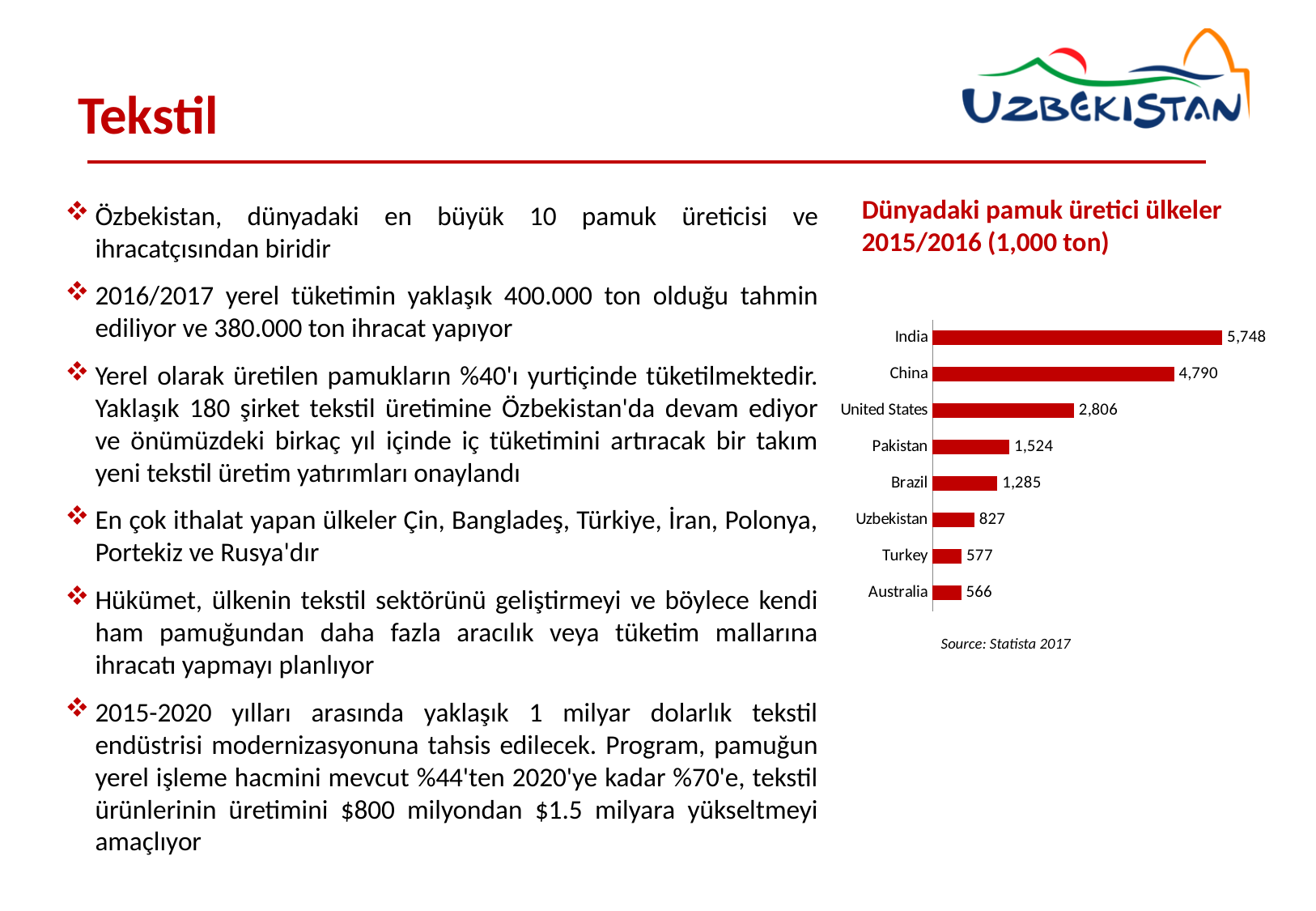
What is the title of the chart? Dünyadaki pamuk üretici ülkeler 2015/2016 (1,000 ton) What source is cited below the chart? Statista 2017 What is the difference between the values for Uzbekistan and Turkey? 250 Which country has the highest value in the chart? India How many countries are shown in the chart? 8 Which is larger, the value for Brazil or the value for Pakistan? Pakistan What is the value for Uzbekistan in the chart? 827 What is the difference between the values for India and China? 958 What kind of chart is shown on the slide? Bar chart What is the value for India in the cotton producing countries chart? 5,748 What is the value for Pakistan in the chart? 1,524 Which country has the lowest value in the chart? Australia